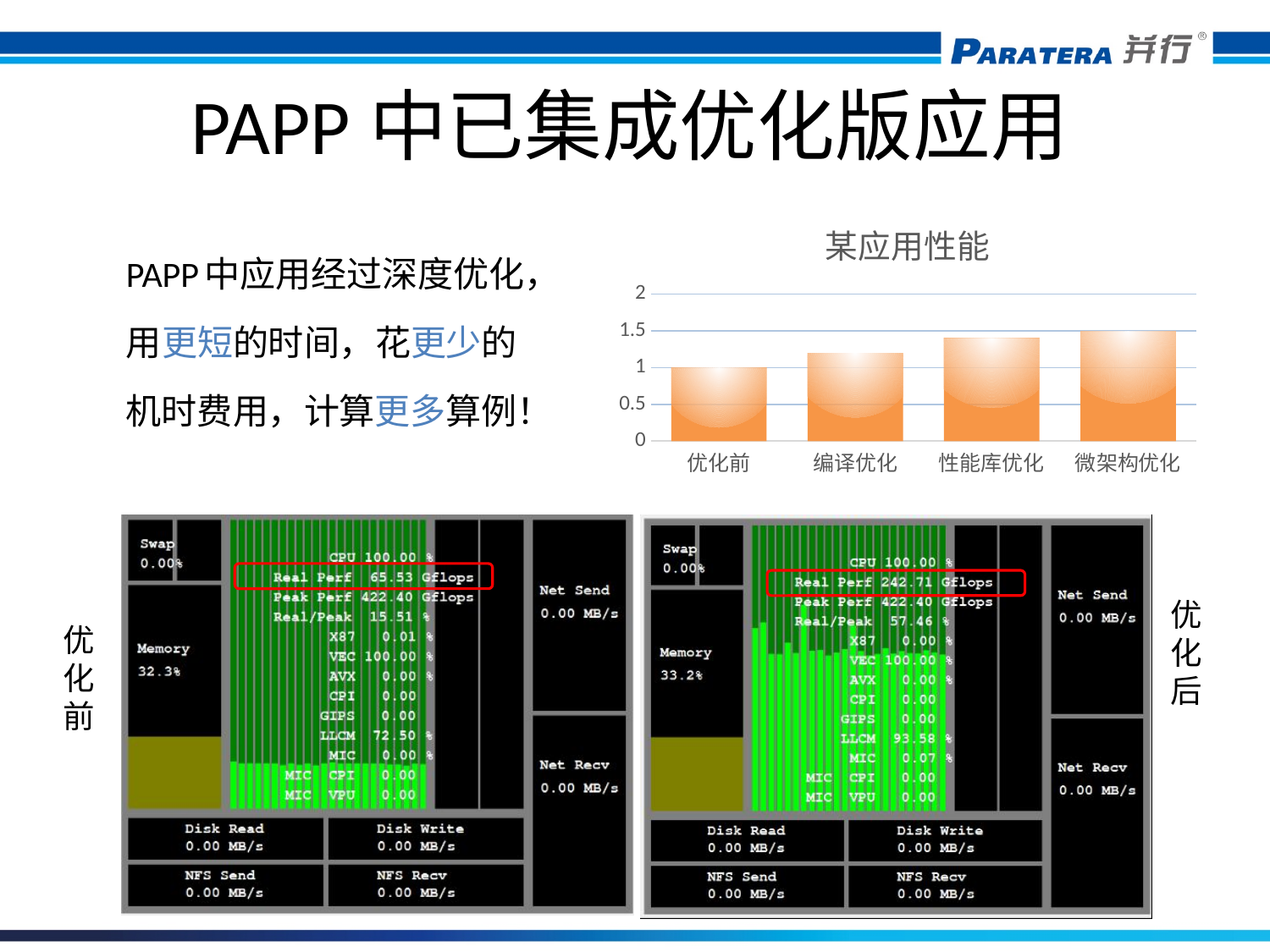
In the 某应用性能 chart, is the value for 性能库优化 greater or less than 1.5? less How many categories are plotted in the 某应用性能 chart? 4 In the 某应用性能 chart, which is larger, the value for 编译优化 or the value for 性能库优化? 性能库优化 In the 某应用性能 chart, is the value for 编译优化 greater or less than 1.5? less In the 某应用性能 chart, do the values rise or fall from left to right along the x axis? rise In the 某应用性能 chart, which category has the lowest bar? 优化前 In the 某应用性能 chart, which category has the highest bar? 微架构优化 What kind of chart is shown under the title 某应用性能? bar chart In the 某应用性能 chart, is the value for 编译优化 greater or less than 1? greater What is the title of the bar chart on the slide? 某应用性能 In the 某应用性能 chart, what is the value for 优化前? 1